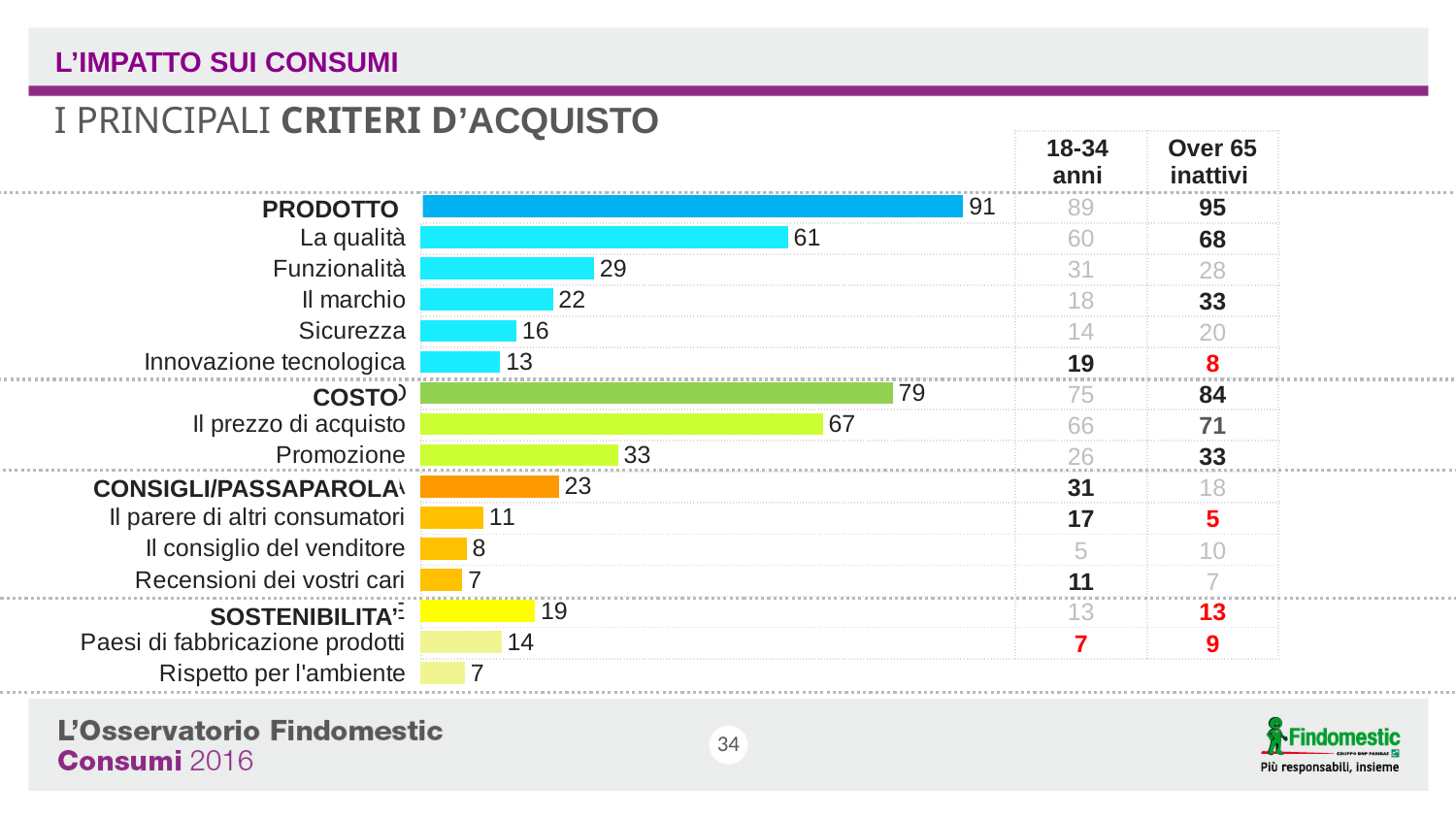
Which category has the highest value in the chart? PRODOTTO What value is shown for Innovazione tecnologica? 13 What value is shown for PRODOTTO in the bar chart? 91 What kind of chart is shown on the slide? Bar chart What is the difference between the values for PRODOTTO and COSTO? 12 Which is larger, the value for CONSIGLI/PASSAPAROLA or the value for Il marchio? CONSIGLI/PASSAPAROLA How many bars are plotted in the chart? 16 What value is shown for Il consiglio del venditore? 8 What value is shown for SOSTENIBILITA'? 19 Which is larger, the value for Promozione or the value for Funzionalità? Promozione What is the difference between the values for Il prezzo di acquisto and La qualità? 6 What value is shown for Il prezzo di acquisto? 67